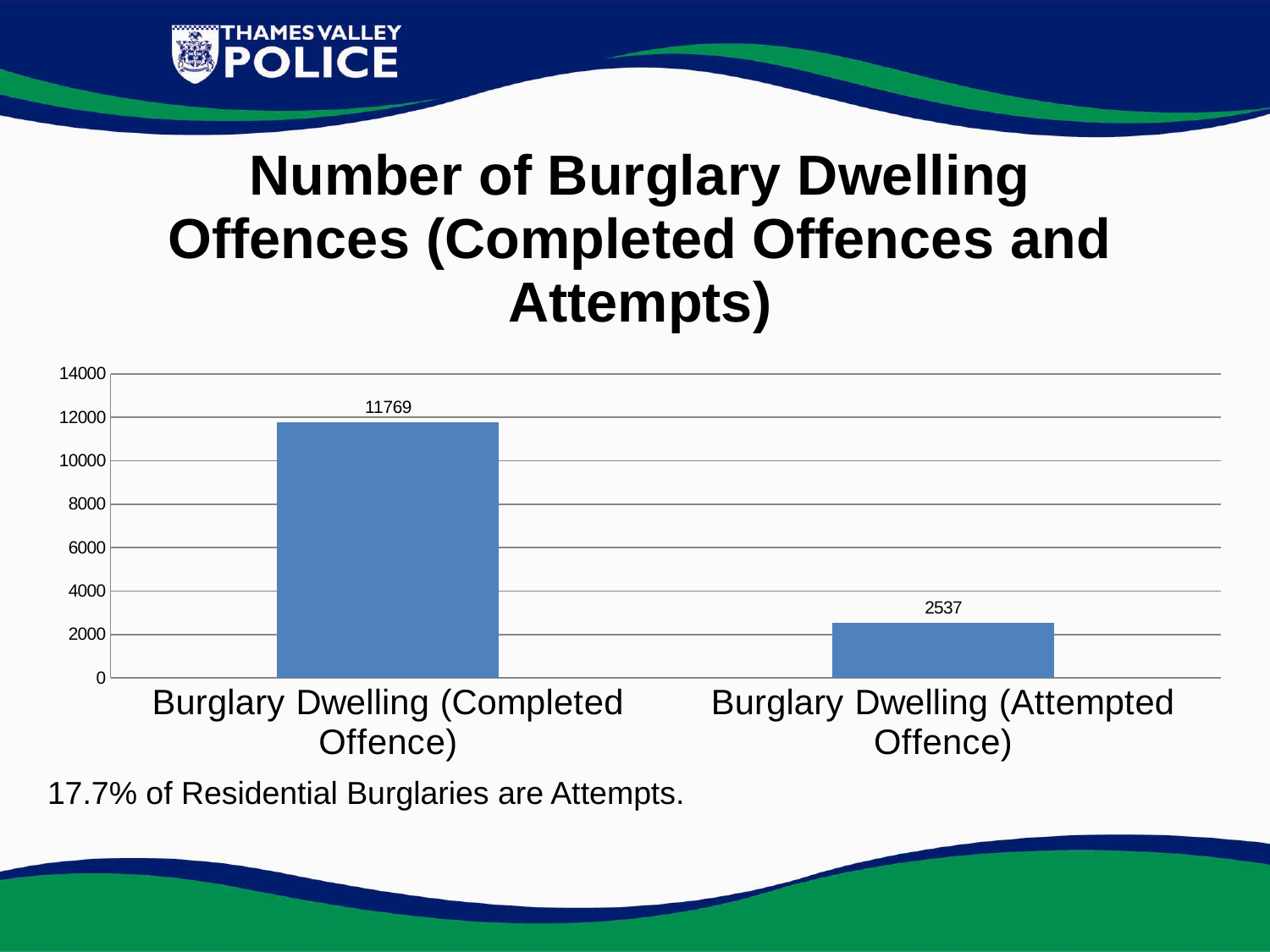
Is the value for Burglary Dwelling (Attempted Offence) greater or less than 4000? less What kind of chart is shown on the slide? bar chart Which is larger, the value for Burglary Dwelling (Completed Offence) or Burglary Dwelling (Attempted Offence)? Burglary Dwelling (Completed Offence) Which category has the highest value? Burglary Dwelling (Completed Offence) What is the difference between the values for Burglary Dwelling (Completed Offence) and Burglary Dwelling (Attempted Offence)? 9232 Is the value for Burglary Dwelling (Completed Offence) greater or less than 10000? greater What is the value for Burglary Dwelling (Completed Offence)? 11769 How many categories are shown on the chart? 2 What is the title of the chart on the slide? Number of Burglary Dwelling Offences (Completed Offences and Attempts) What is the total of the two values shown on the chart? 14306 Which category has the lowest value? Burglary Dwelling (Attempted Offence) What is the value for Burglary Dwelling (Attempted Offence)? 2537